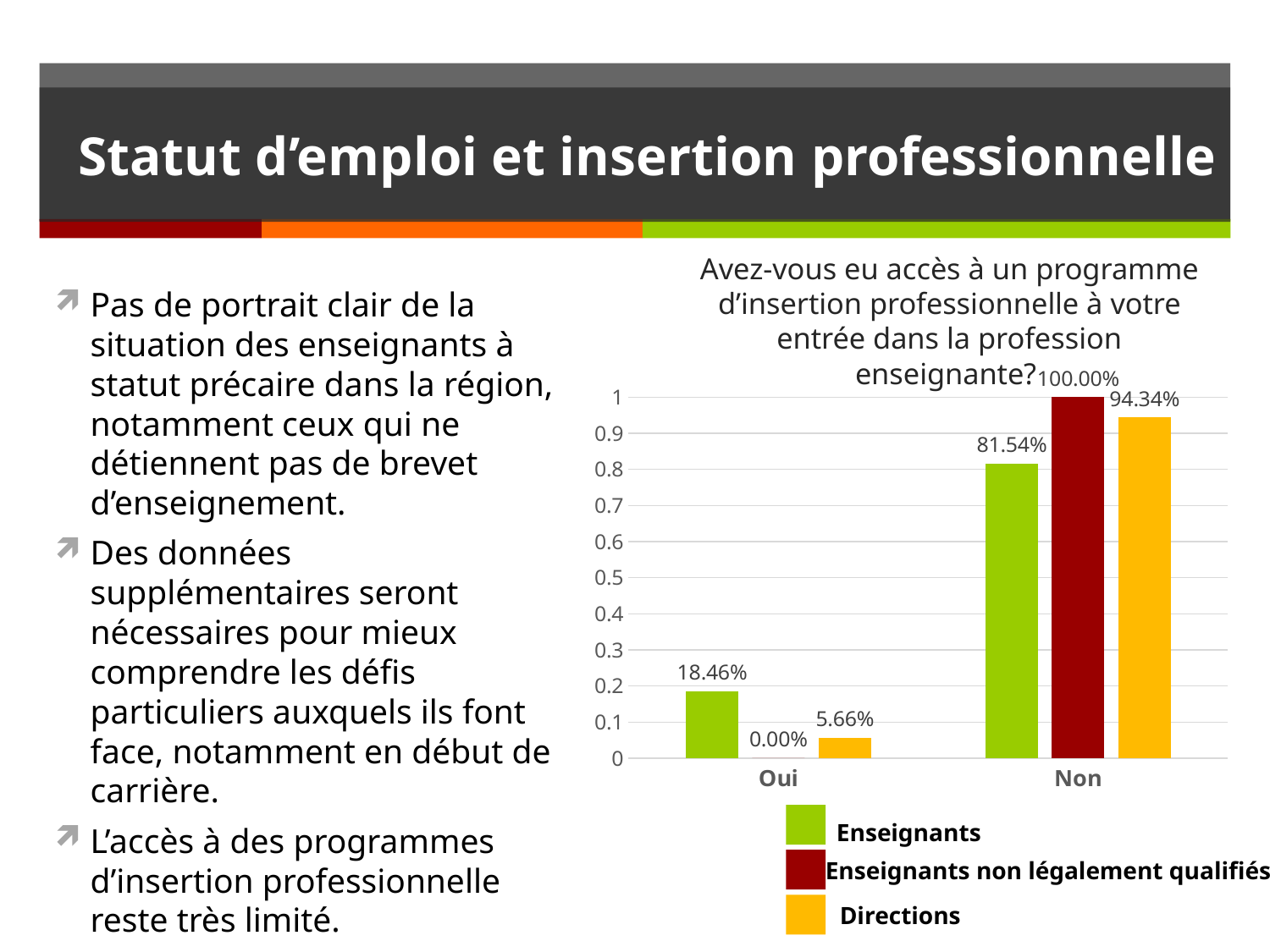
Which is larger: the Directions value for Oui or the Enseignants value for Oui? Enseignants What value is shown for Enseignants in the Oui category? 18.46% What value is shown for Directions in the Non category? 94.34% What kind of chart is shown on the slide? Bar chart How many categories are shown on the x axis? 2 What value is shown for Enseignants in the Non category? 81.54% What is the difference between the Non and Oui values for Enseignants? 63.08% Which series has the highest value in the Non category? Enseignants non légalement qualifiés Which series has the lowest value in the Oui category? Enseignants non légalement qualifiés How many series does the legend list? 3 What value is shown for Enseignants non légalement qualifiés in the Oui category? 0.00% What colour represents the Directions series? Yellow/orange